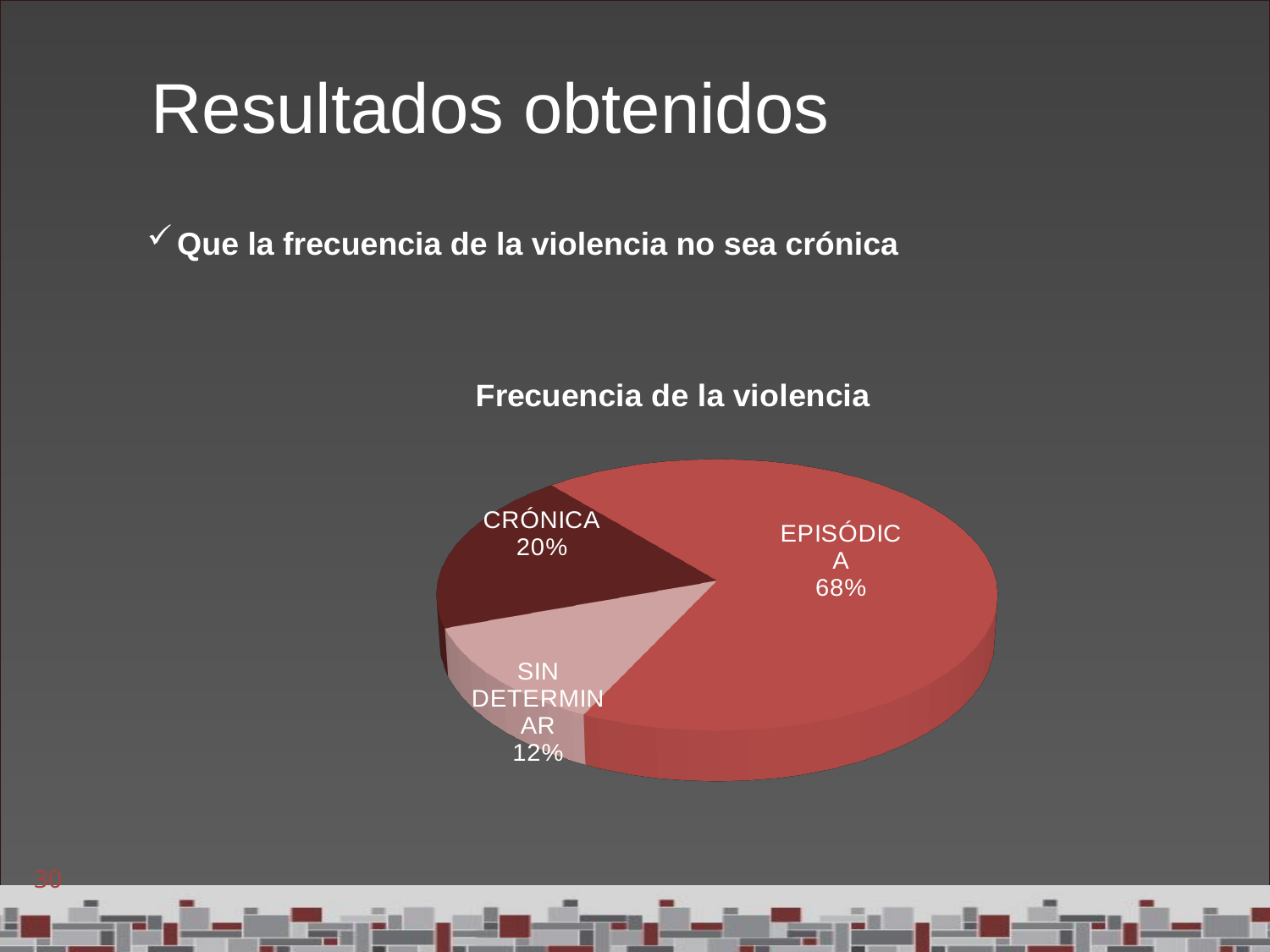
Which slice of the pie is the smallest? SIN DETERMINAR Which slice of the pie is the largest? EPISÓDICA What percentage of the pie is CRÓNICA? 20% Which is larger, the CRÓNICA slice or the SIN DETERMINAR slice? CRÓNICA What is the difference in percentage points between CRÓNICA and SIN DETERMINAR? 8 What percentage of the pie is SIN DETERMINAR? 12% What is the difference in percentage points between EPISÓDICA and CRÓNICA? 48 What percentage of the pie is EPISÓDICA? 68% What share of the pie do CRÓNICA and SIN DETERMINAR make up together? 32% What is the title of the chart? Frecuencia de la violencia What kind of chart is shown on the slide? pie chart How many slices does the pie chart have? 3